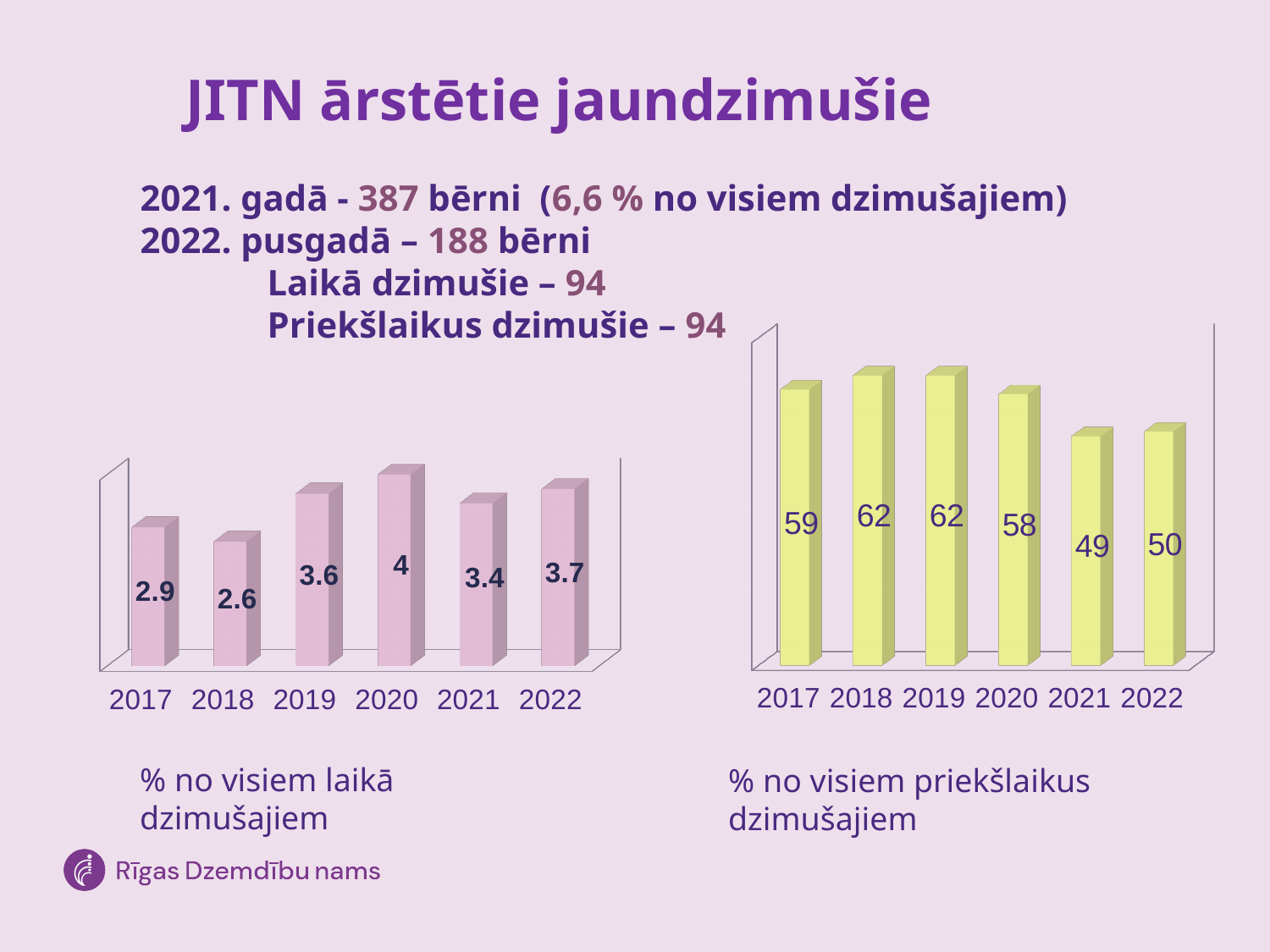
What is the title of the slide? JITN ārstētie jaundzimušie In the left chart (% no visiem laikā dzimušajiem), what is the value for 2019? 3.6 In the left chart (% no visiem laikā dzimušajiem), what is the difference between the values for 2020 and 2018? 1.4 In the right chart (% no visiem priekšlaikus dzimušajiem), do the values generally rise or fall from 2019 to 2021? fall In the left chart (% no visiem laikā dzimušajiem), which year has the lowest value? 2018 In the left chart (% no visiem laikā dzimušajiem), which year has the highest value? 2020 In the right chart (% no visiem priekšlaikus dzimušajiem), is the value for 2017 larger or smaller than the value for 2022? larger In the right chart (% no visiem priekšlaikus dzimušajiem), what is the value for 2020? 58 In the right chart (% no visiem priekšlaikus dzimušajiem), what is the difference between the values for 2018 and 2021? 13 What kind of chart is the right chart (% no visiem priekšlaikus dzimušajiem)? bar chart In the left chart (% no visiem laikā dzimušajiem), how many years are shown? 6 In the right chart (% no visiem priekšlaikus dzimušajiem), which year has the lowest value? 2021